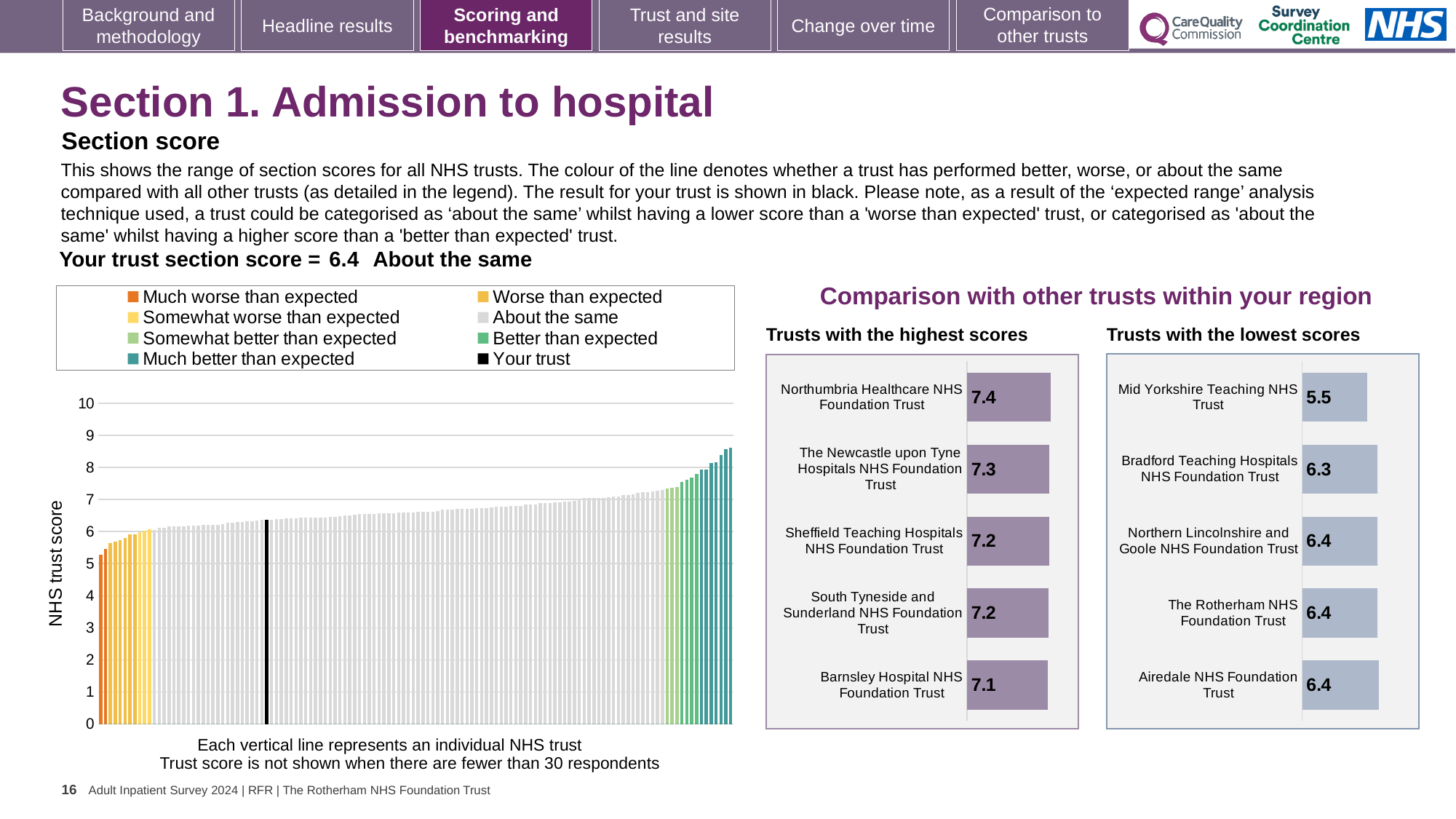
In the 'Trusts with the lowest scores' chart, what is the score for Mid Yorkshire Teaching NHS Trust? 5.5 In the 'Trusts with the highest scores' chart, is the score for The Newcastle upon Tyne Hospitals NHS Foundation Trust larger or smaller than the score for Sheffield Teaching Hospitals NHS Foundation Trust? larger In the 'Trusts with the lowest scores' chart, how many trusts are shown? 5 In the main section score chart on the left, what kind of chart is it? bar chart In the main section score chart on the left, how many entries does the legend list? 8 In the 'Trusts with the highest scores' chart, what is the score for Northumbria Healthcare NHS Foundation Trust? 7.4 In the 'Trusts with the lowest scores' chart, which trust has the lowest score? Mid Yorkshire Teaching NHS Trust In the 'Trusts with the lowest scores' chart, what is the difference between the scores of Bradford Teaching Hospitals NHS Foundation Trust and Mid Yorkshire Teaching NHS Trust? 0.8 In the 'Trusts with the highest scores' chart, what is the score for Barnsley Hospital NHS Foundation Trust? 7.1 In the 'Trusts with the highest scores' chart, what is the difference between the scores of Northumbria Healthcare NHS Foundation Trust and Barnsley Hospital NHS Foundation Trust? 0.3 In the main section score chart on the left, do the trust scores rise or fall from left to right? rise In the 'Trusts with the highest scores' chart, which trust has the highest score? Northumbria Healthcare NHS Foundation Trust